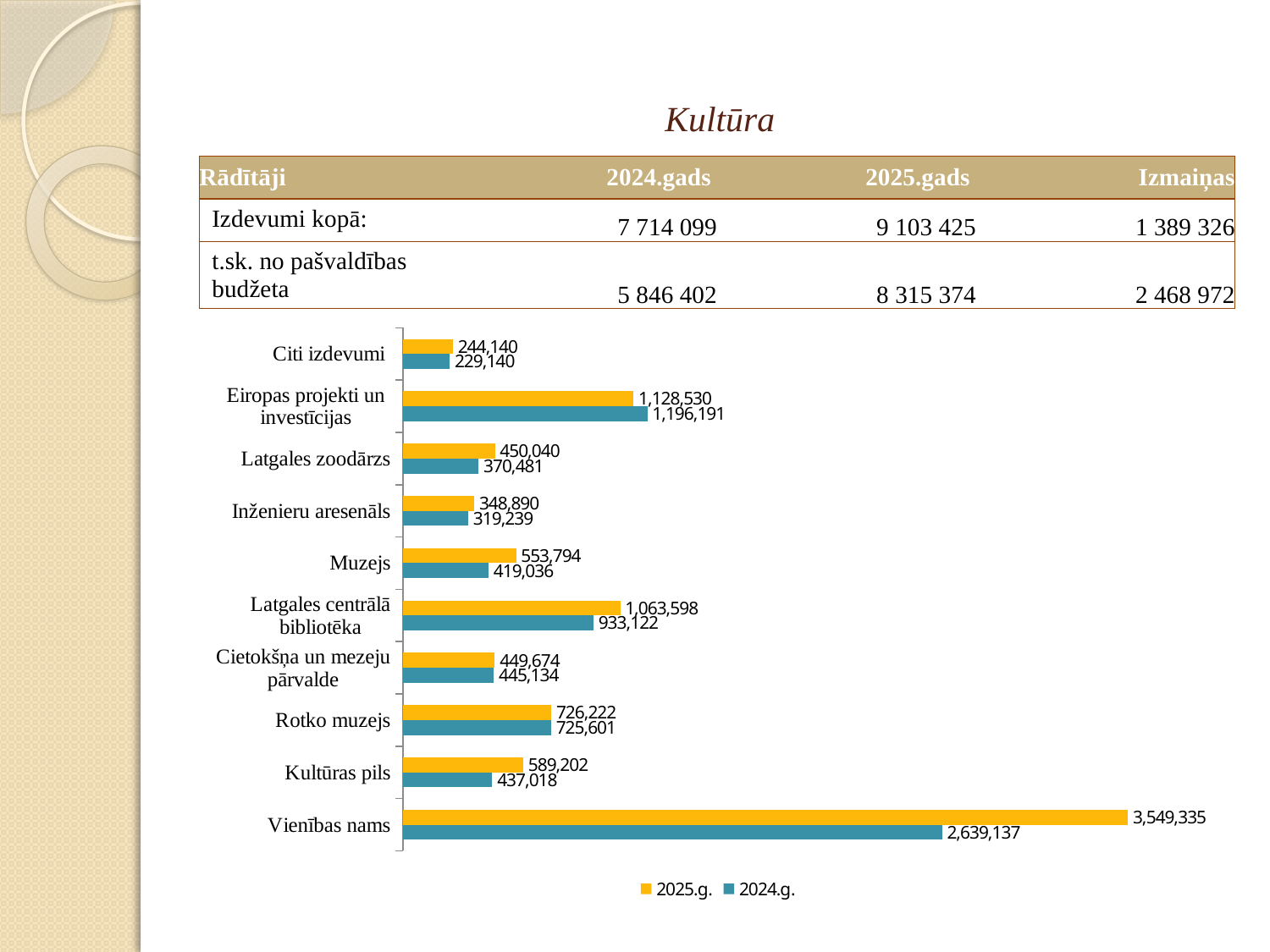
What is the 2025.g. value for Muzejs? 553,794 What is the difference between the 2025.g. and 2024.g. values for Vienības nams? 910,198 What kind of chart is shown on the slide? Bar chart Which category has the highest 2025.g. value? Vienības nams How many series does the chart legend list? 2 What is the 2024.g. value for Eiropas projekti un investīcijas? 1,196,191 For Eiropas projekti un investīcijas, which is larger: the 2024.g. value or the 2025.g. value? 2024.g. What is the difference between the 2025.g. and 2024.g. values for Kultūras pils? 152,184 What is the 2024.g. value for Latgales centrālā bibliotēka? 933,122 How many categories are shown in the bar chart? 10 What is the 2025.g. value for Vienības nams? 3,549,335 Which category has the lowest 2024.g. value? Citi izdevumi